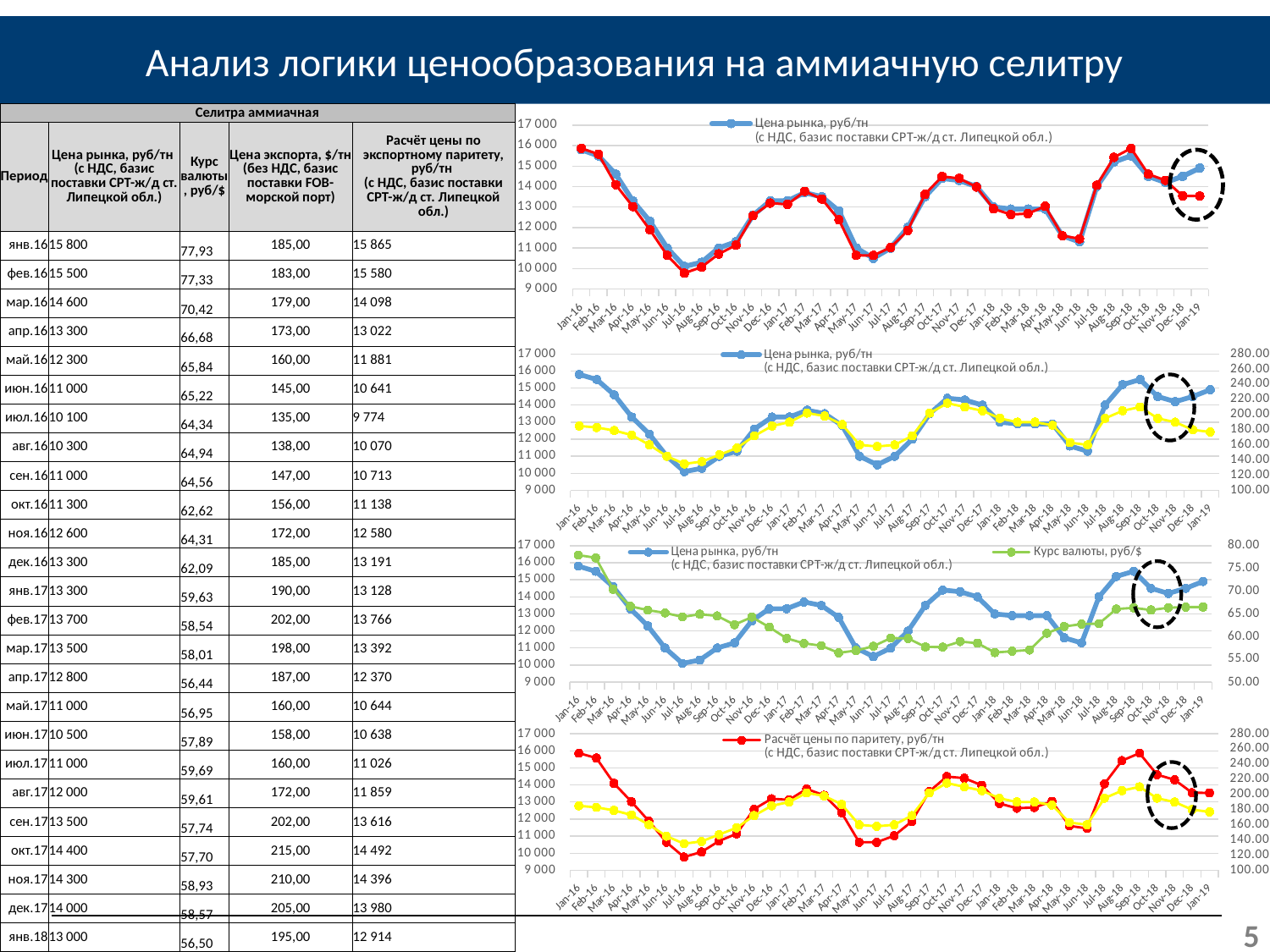
In the top chart, does the blue line rise or fall from Jan-16 to Jul-16? fall What type of chart is the top chart on the right side of the slide? line chart In the top chart, is the value of the red line at Jan-19 greater or less than 14 000? less In the third chart from the top, is the value of the green line at Apr-17 greater or less than 60.00? less In the top chart, at Jan-19, which line is higher, the blue line or the red line? blue line In the third chart from the top, how many series does the legend list? 2 In the top chart, is the value of the blue line at Jan-16 greater or less than 15 000? greater In the bottom chart, in which month is the red line at its lowest? Jul-16 In the third chart from the top, what is the name of the green series in the legend? Курс валюты, руб/$ In the bottom chart, what is the name of the red series in the legend? Расчёт цены по паритету, руб/тн How many charts are shown on the right side of the slide? 4